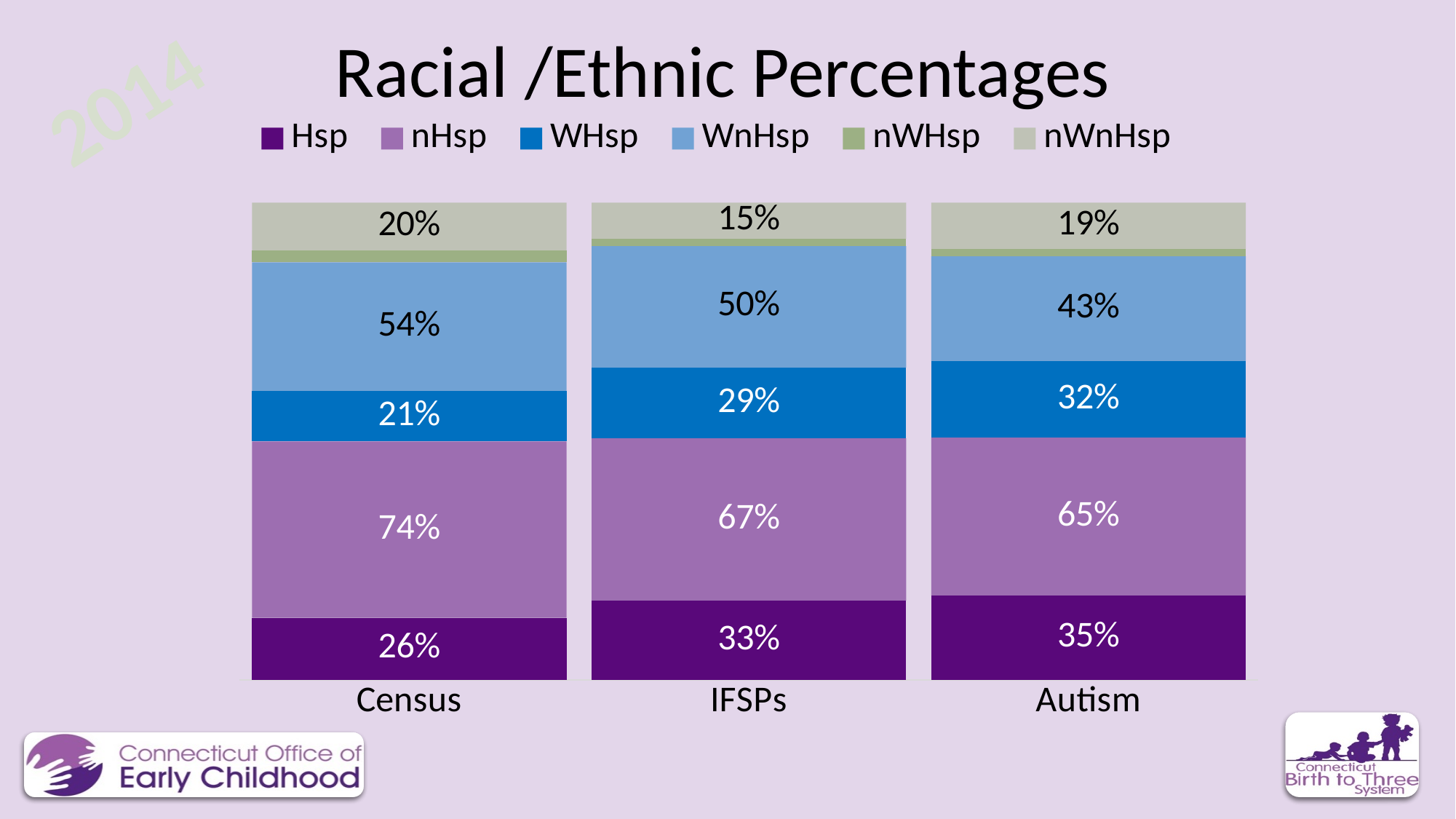
What is the Hsp value for Census? 26% What is the nWnHsp value for IFSPs? 15% Which is larger, the nHsp value for Census or the nHsp value for Autism? Census What is the nHsp value for IFSPs? 67% What is the difference between the WHsp values for Autism and Census? 11% Which category has the lowest WnHsp value? Autism How many categories are shown on the x axis? 3 How many series does the legend list? 6 Which category has the highest Hsp value? Autism What is the title of the chart? Racial /Ethnic Percentages What is the WnHsp value for Autism? 43% What kind of chart is shown on the slide? Stacked bar chart